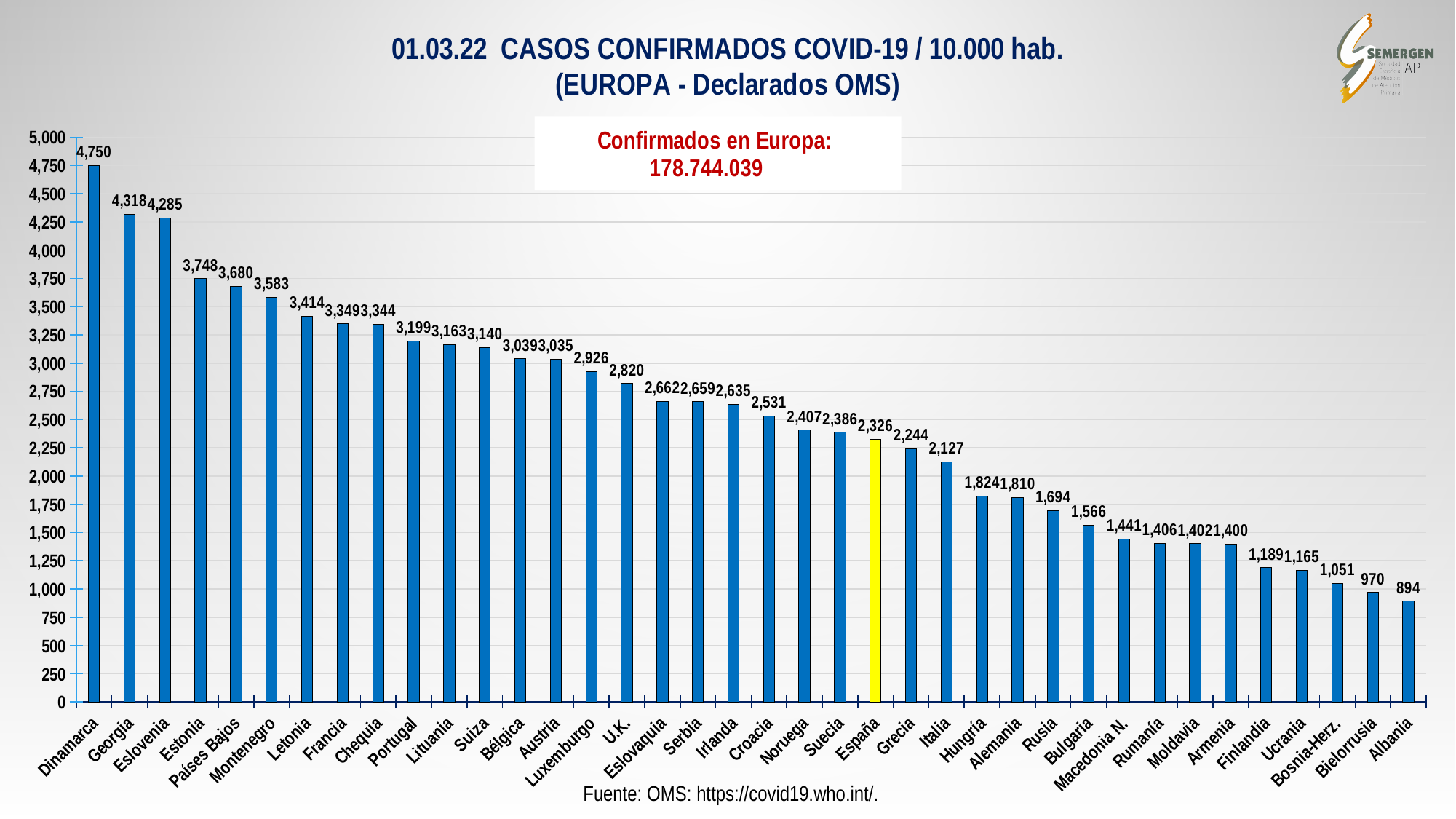
How many countries are shown on the chart? 38 Which is larger, the value for Francia or the value for Italia? Francia Do the values rise or fall from left to right along the x axis? Fall What is the difference between the values for España and Italia? 199 What is the value for Portugal? 3,199 What is the value for España? 2,326 Which country's bar is highlighted in yellow? España Which country has the lowest value? Albania What is the value for Alemania? 1,810 Which country has the highest value? Dinamarca What is the difference between the values for Dinamarca and Albania? 3,856 What kind of chart is shown on the slide? Bar chart